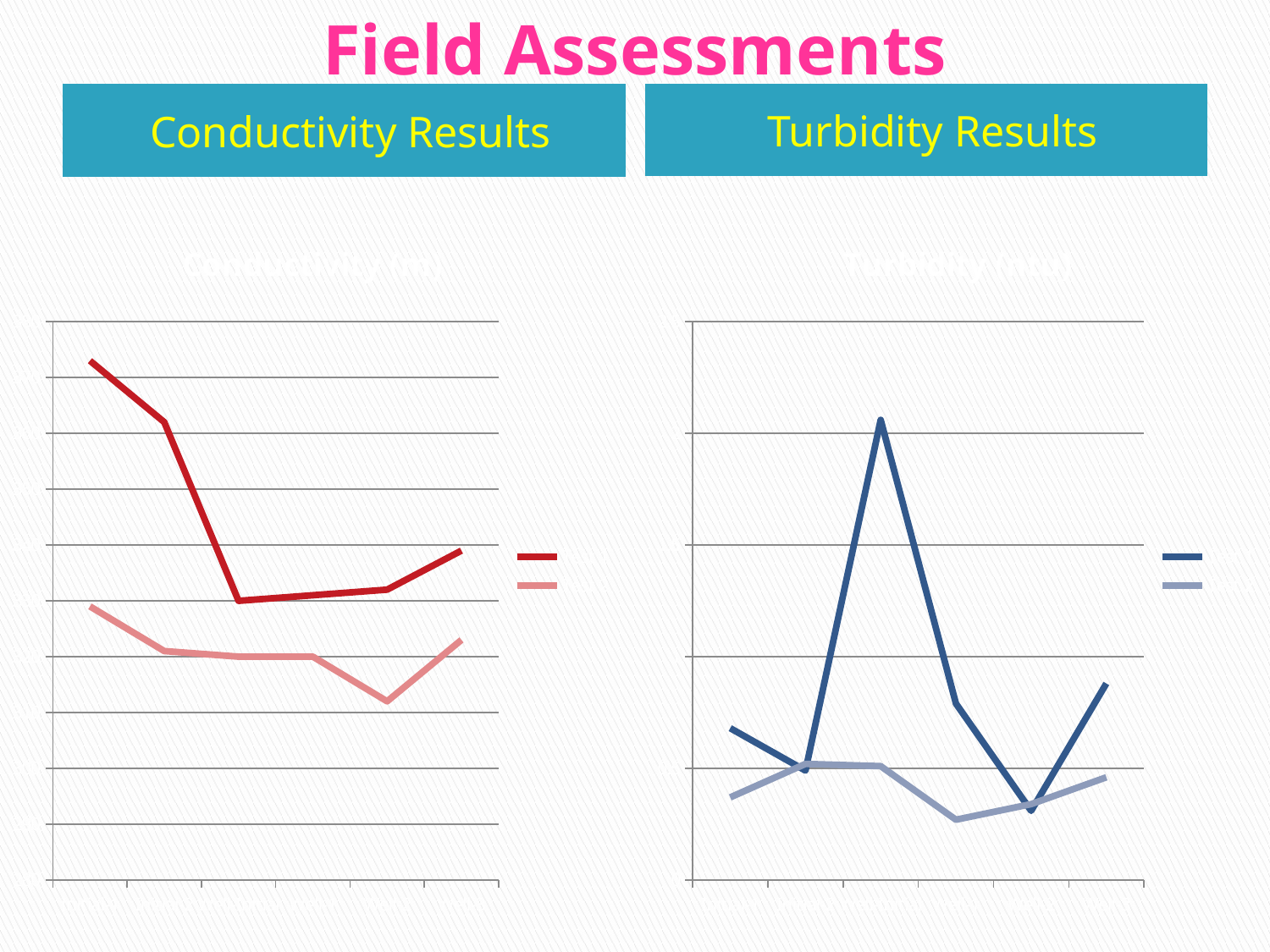
How many series does the legend of the Turbidity chart list? 2 In the Conductivity chart, does the dark red line rise or fall from its first point to its last point? fall In the Turbidity chart, which line reaches the highest peak, the dark blue line or the light blue line? the dark blue line What kind of chart is the Turbidity chart on the right? line chart What kind of chart is the Conductivity chart on the left? line chart In the Turbidity chart, does the dark blue line rise or fall between its third and fourth points? fall What are the two section headings above the charts? Conductivity Results and Turbidity Results How many series does the legend of the Conductivity chart list? 2 How many data points does each line in the Conductivity chart have? 6 What is the main title at the top of the slide? Field Assessments In the Conductivity chart, which line is higher at every point, the dark red line or the light red line? the dark red line How many data points does each line in the Turbidity chart have? 6